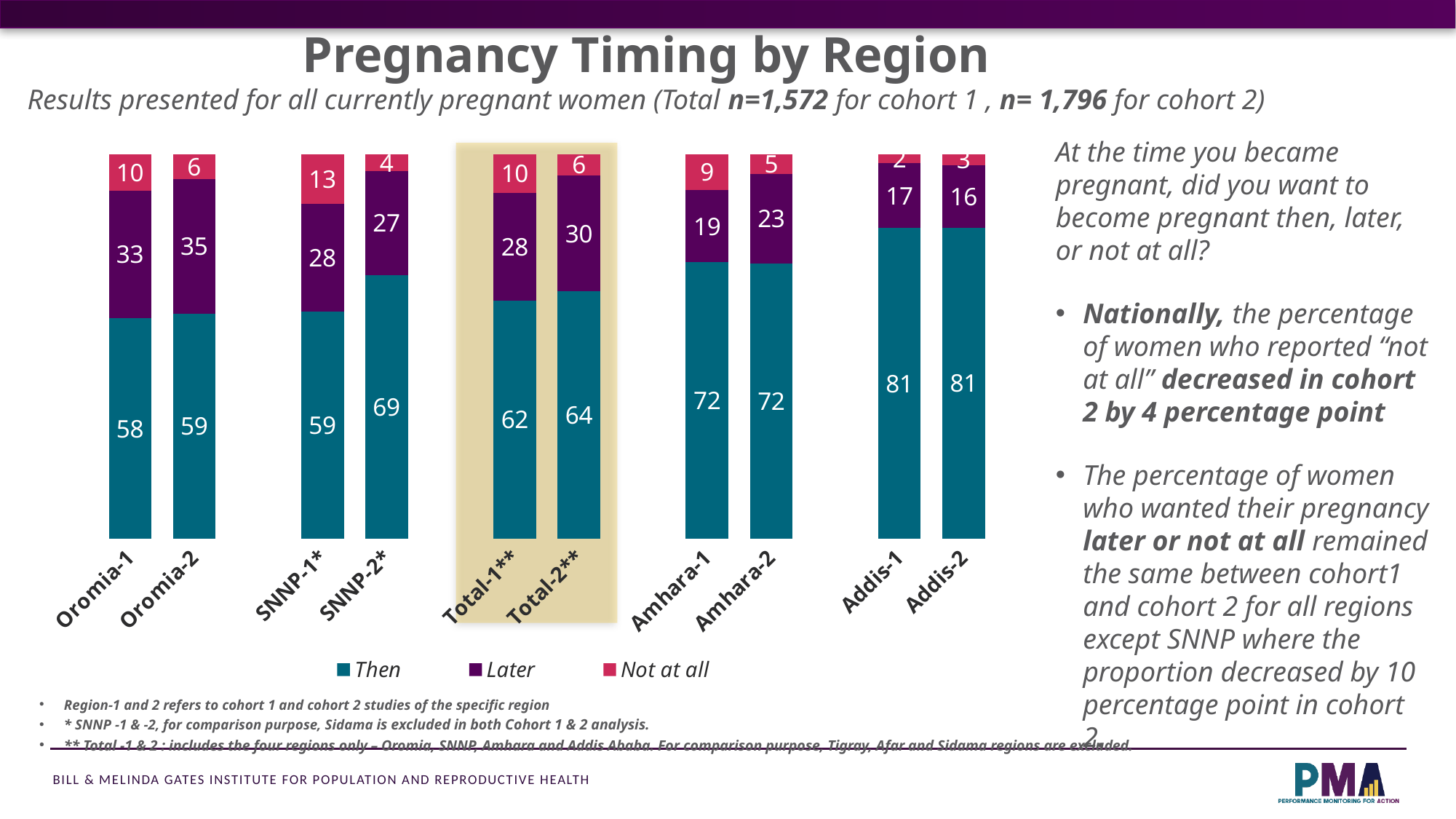
How many bars (region-cohort categories) are plotted in the chart? 10 What type of chart is shown on the slide? Stacked bar chart What is the total of the stacked bar for Oromia-2? 100 Which is larger, the 'Later' value for Total-1** or for Total-2**? Total-2** What is the 'Later' value for Amhara-2? 23 What is the difference between the 'Then' values for SNNP-2* and SNNP-1*? 10 Which category has the highest 'Not at all' value? SNNP-1* Which category has the lowest 'Not at all' value? Addis-1 How many series does the legend list? 3 What is the 'Then' value for Oromia-1? 58 What is the 'Not at all' value for SNNP-1*? 13 Which legend entry is shown in teal? Then